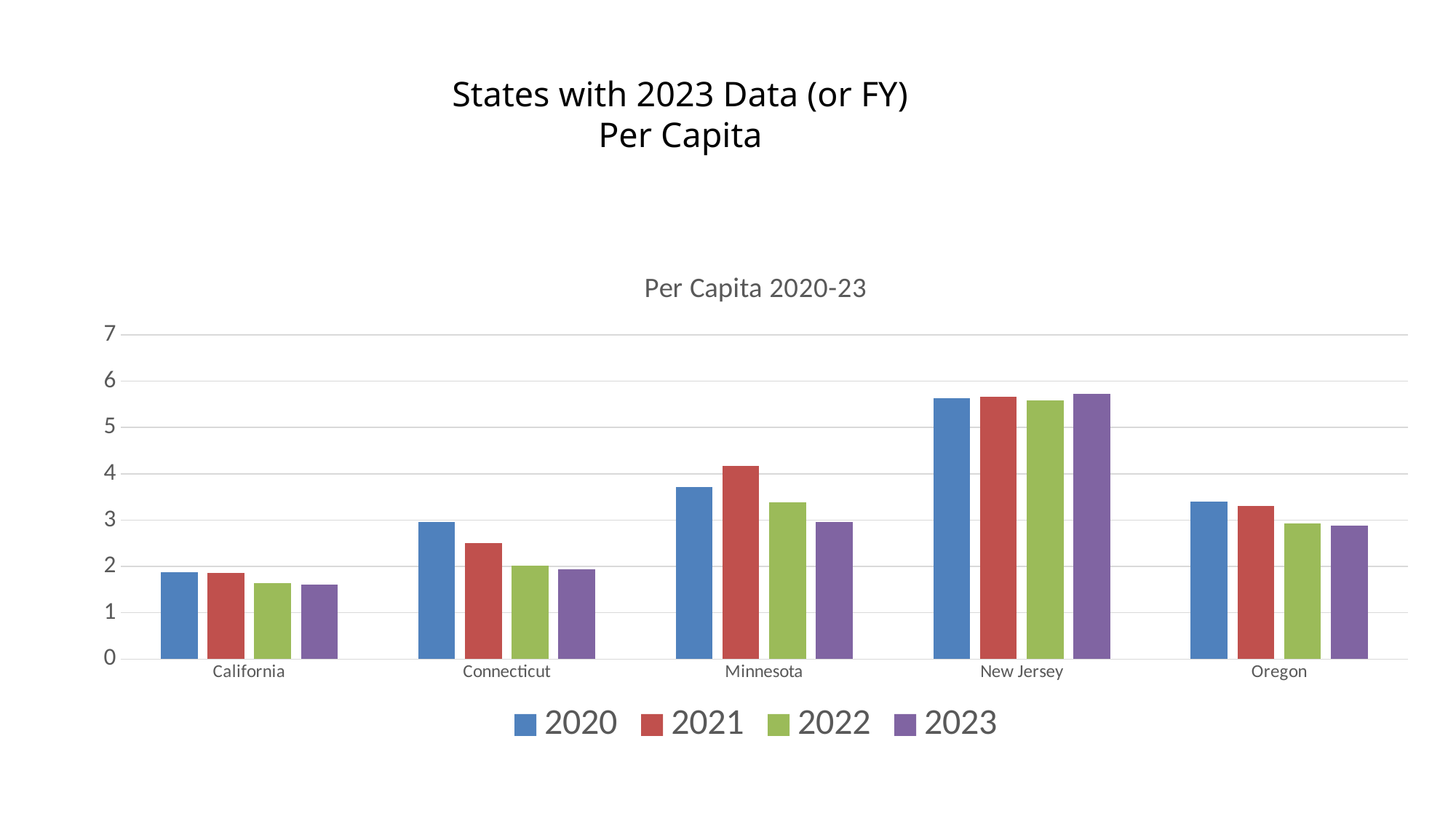
Which state has the highest value for 2023? New Jersey For Minnesota, which year has the larger value, 2020 or 2021? 2021 Is the value for Oregon in 2020 greater or less than 3? greater Do the values for California rise or fall from 2020 to 2023? fall Which state has the lowest value for 2020? California How many states are shown on the x axis of the chart? 5 Is the value for Minnesota in 2021 greater or less than 4? greater What kind of chart is shown on the slide? Bar chart Which state has the larger value for 2020, Connecticut or Oregon? Oregon How many series does the legend list? 4 What is the title printed above the chart's plot area? Per Capita 2020-23 Is the value for New Jersey in 2023 greater or less than 5? greater